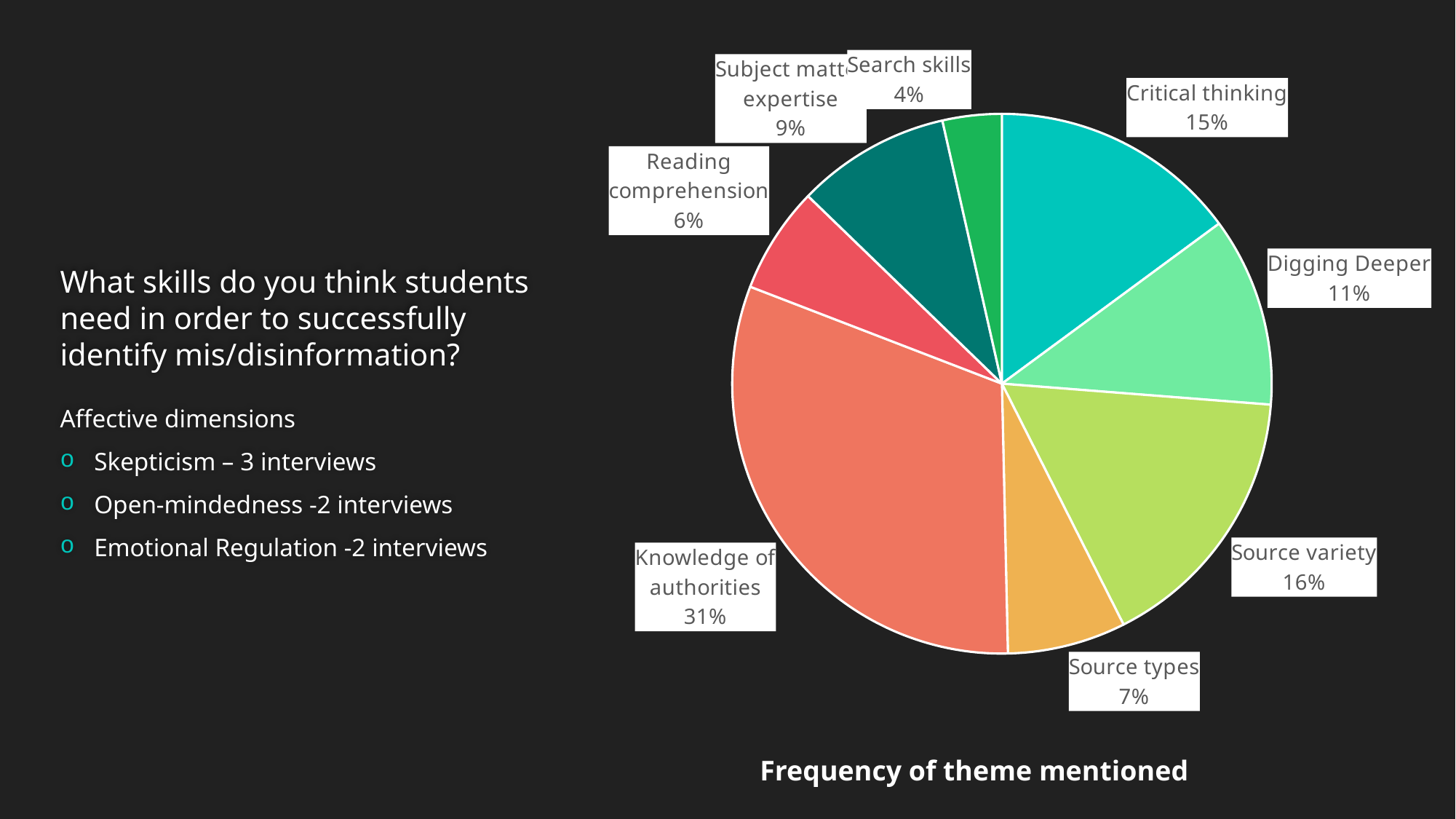
What share of the pie does Knowledge of authorities take? 31% Which theme has the largest slice of the pie? Knowledge of authorities What is the difference in percentage points between Knowledge of authorities and Source variety? 15 What percentage is shown for Critical thinking? 15% What kind of chart is shown on the slide? pie chart Which is larger, Digging Deeper or Subject matter expertise? Digging Deeper What is the title of the chart? Frequency of theme mentioned What percentage is shown for Source variety? 16% Which theme has the smallest slice of the pie? Search skills What percentage is shown for Reading comprehension? 6% What percentage is shown for Search skills? 4% How many slices does the pie chart have? 8